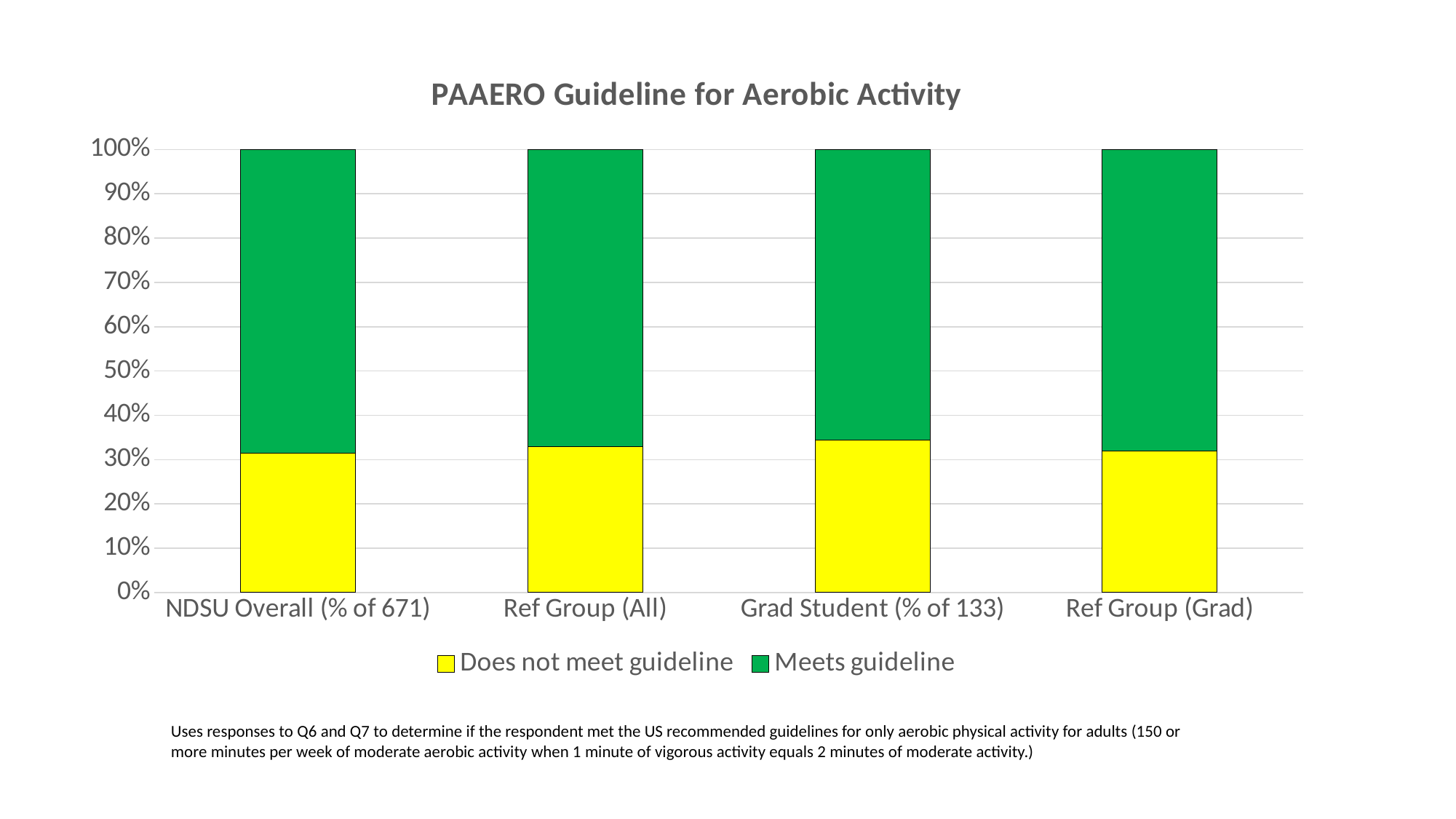
Is the 'Does not meet guideline' value for Grad Student (% of 133) greater or less than 40%? less Is the 'Does not meet guideline' value for Grad Student (% of 133) greater or less than 30%? greater Is the 'Does not meet guideline' value for NDSU Overall (% of 671) greater or less than 40%? less How many series does the legend list? 2 What is the total height of the stacked bar for NDSU Overall (% of 671)? 100% What kind of chart is shown on the slide? Stacked bar chart How many categories are shown on the x axis of the chart? 4 Which colour represents the 'Meets guideline' series? Green For each category, which series occupies the larger share of the bar, 'Does not meet guideline' or 'Meets guideline'? Meets guideline What is the title of the chart? PAAERO Guideline for Aerobic Activity